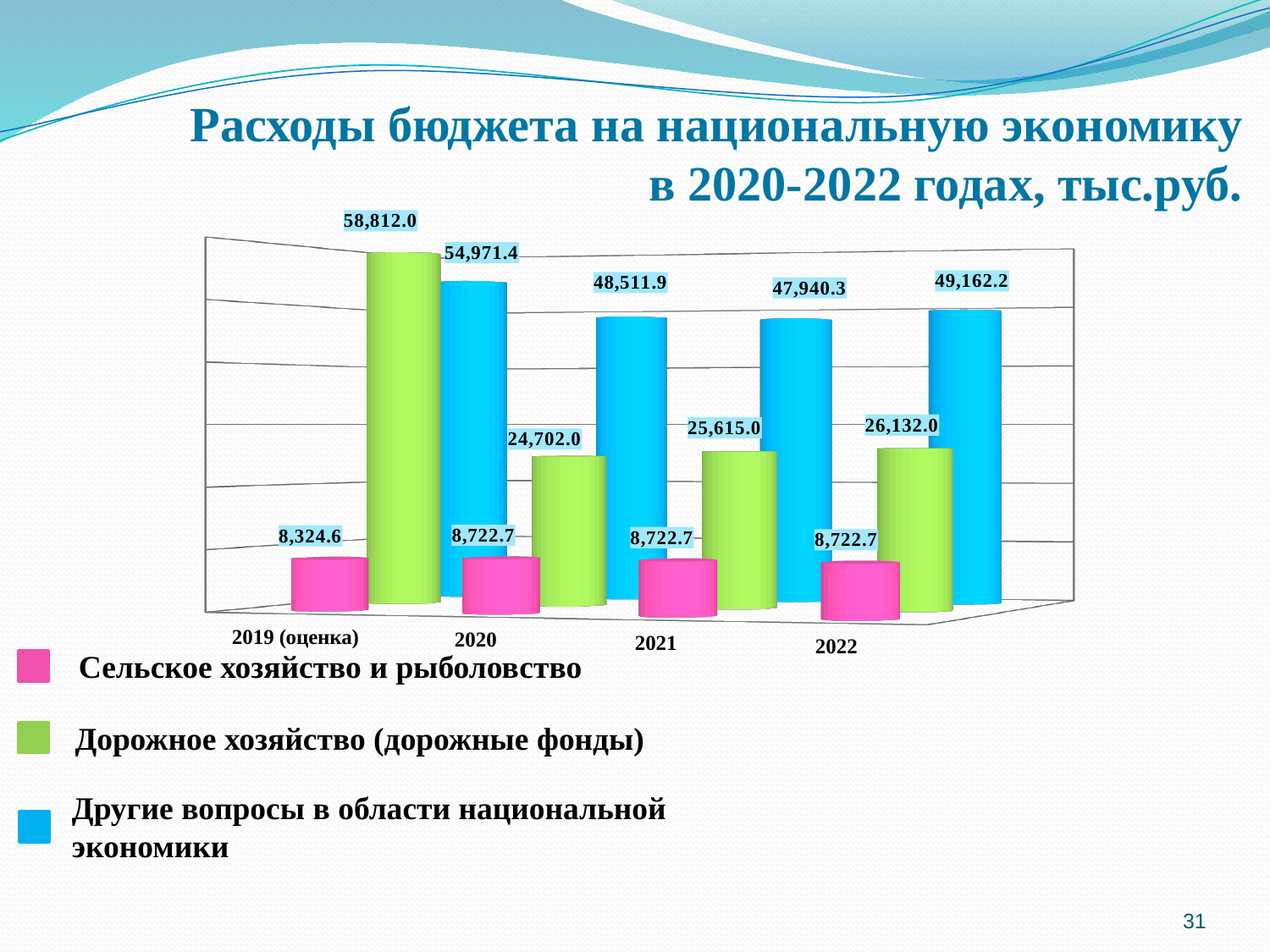
Which colour represents Сельское хозяйство и рыболовство in the legend? Pink What kind of chart is shown on the slide? Bar chart Which is larger in 2019 (оценка): Дорожное хозяйство (дорожные фонды) or Другие вопросы в области национальной экономики? Дорожное хозяйство (дорожные фонды) In which year is the value for Другие вопросы в области национальной экономики the highest? 2019 (оценка) What is the value for Дорожное хозяйство (дорожные фонды) in 2019 (оценка)? 58,812.0 How many series does the legend list? 3 What is the value for Сельское хозяйство и рыболовство in 2022? 8,722.7 What is the value for Дорожное хозяйство (дорожные фонды) in 2020? 24,702.0 What is the value for Другие вопросы в области национальной экономики in 2021? 47,940.3 In which year is the value for Дорожное хозяйство (дорожные фонды) the lowest? 2020 What is the difference between the Дорожное хозяйство (дорожные фонды) values in 2022 and 2021? 517.0 How many years (categories) are shown on the x axis? 4